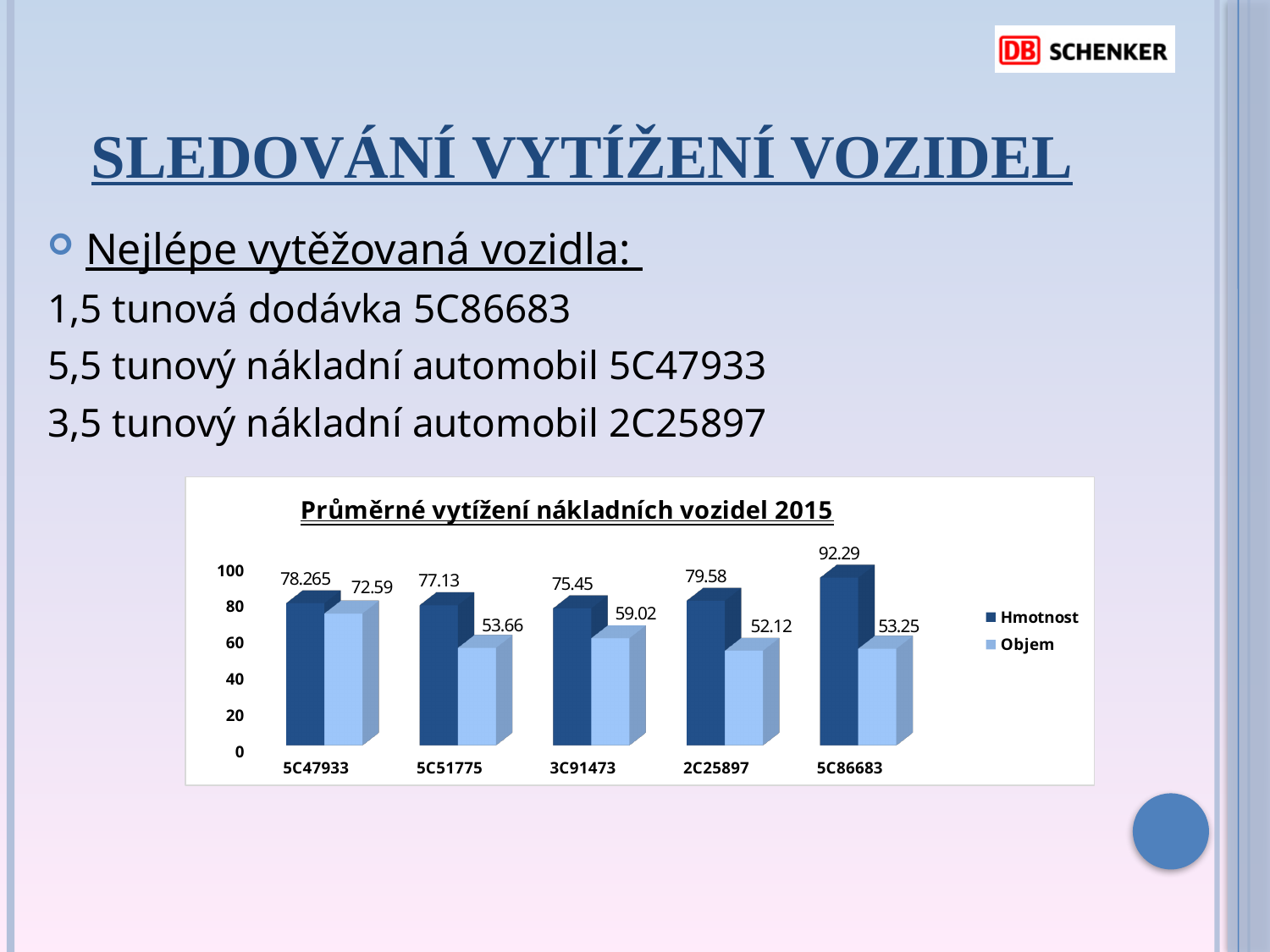
Which is larger, the Objem value for 5C47933 or the Objem value for 5C86683? 5C47933 Which vehicle has the highest Hmotnost value? 5C86683 Which vehicle has the lowest Objem value? 2C25897 What is the Hmotnost value for 5C86683? 92.29 How many series does the legend list? 2 Is the Hmotnost value for 2C25897 greater or less than 60? greater What is the difference between the Hmotnost and Objem values for 5C51775? 23.47 What kind of chart is shown? bar chart What is the Hmotnost value for 5C47933? 78.265 What is the Objem value for 3C91473? 59.02 What is the title of the chart? Průměrné vytížení nákladních vozidel 2015 How many vehicles are shown on the x axis? 5